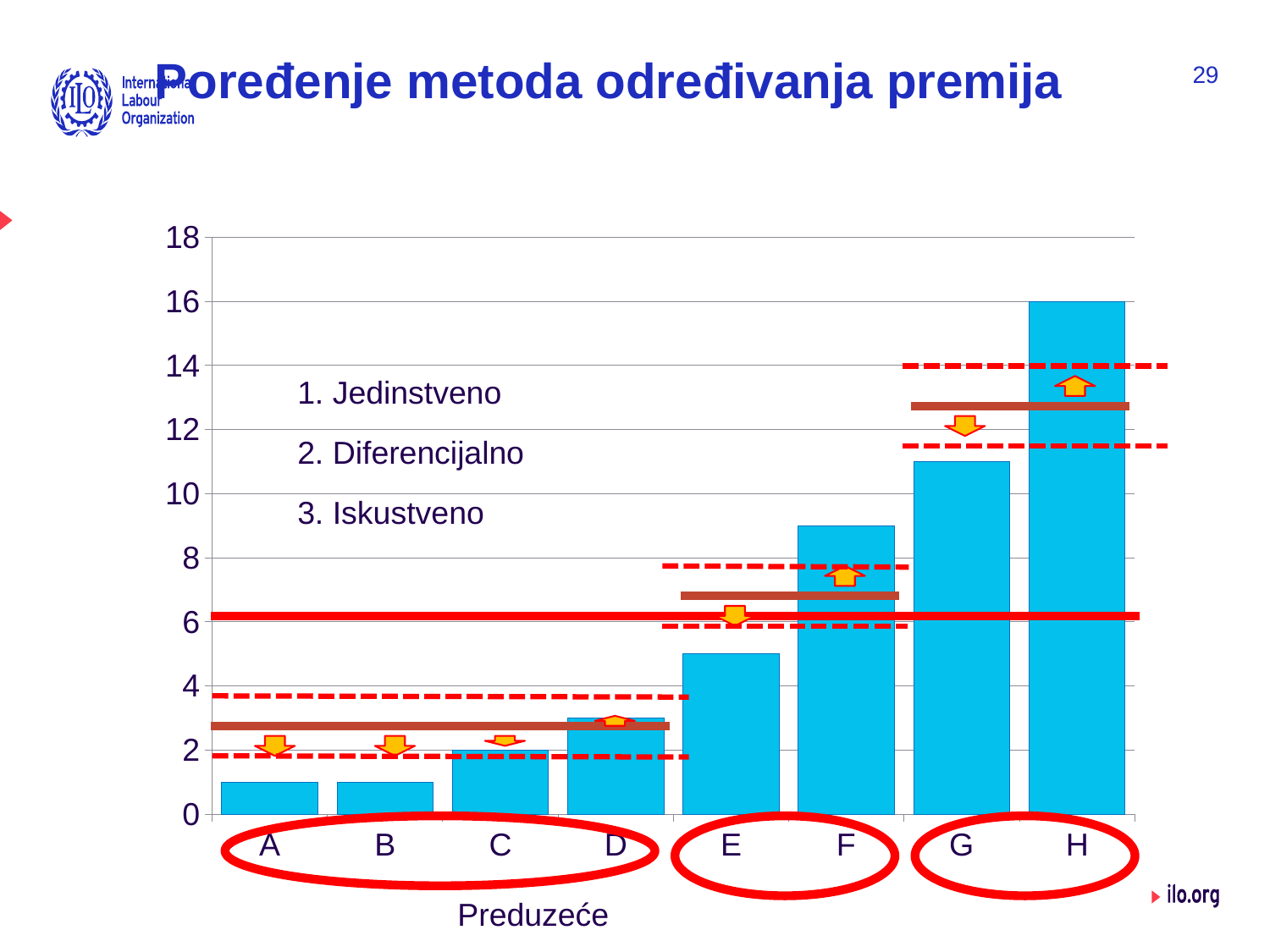
What is the value of the bar for C? 2 Which bar is taller, D or E? E Is the value for G greater or less than 10? greater What is the label of the x axis of the chart? Preduzeće What is the value of the bar for H? 16 Do the bar values generally rise or fall from A to H along the x axis? rise Is the value for F greater or less than 8? greater Is the value for E greater or less than 6? less How many categories (preduzeća) are shown on the x axis of the chart? 8 What kind of chart is shown on the slide? bar chart Which category has the highest bar in the chart? H